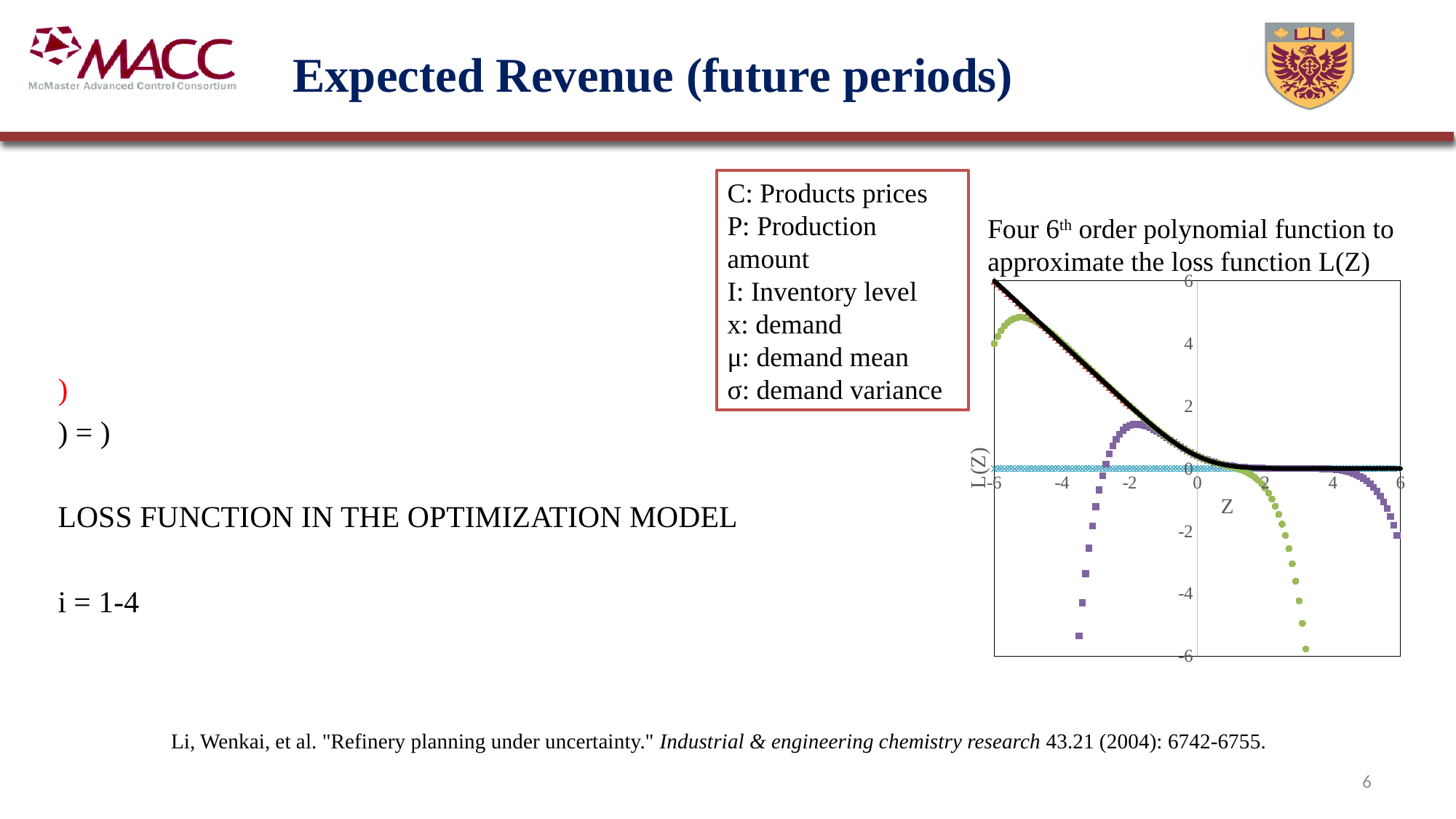
What is the maximum tick value shown on the horizontal Z axis? 6 Does the black curve L(Z) rise or fall as Z increases from -6 to 6? fall Which is larger on the black curve: the value at Z = -4 or the value at Z = 2? Z = -4 What is the label of the vertical axis of the chart? L(Z) Is the value of the black curve at Z = 0 greater or less than 2? less What is the label of the horizontal axis of the chart? Z Is the value of the black curve at Z = -6 greater or less than 4? greater What kind of chart is shown on the slide? scatter chart Is the value of the black curve at Z = 4 greater or less than 2? less